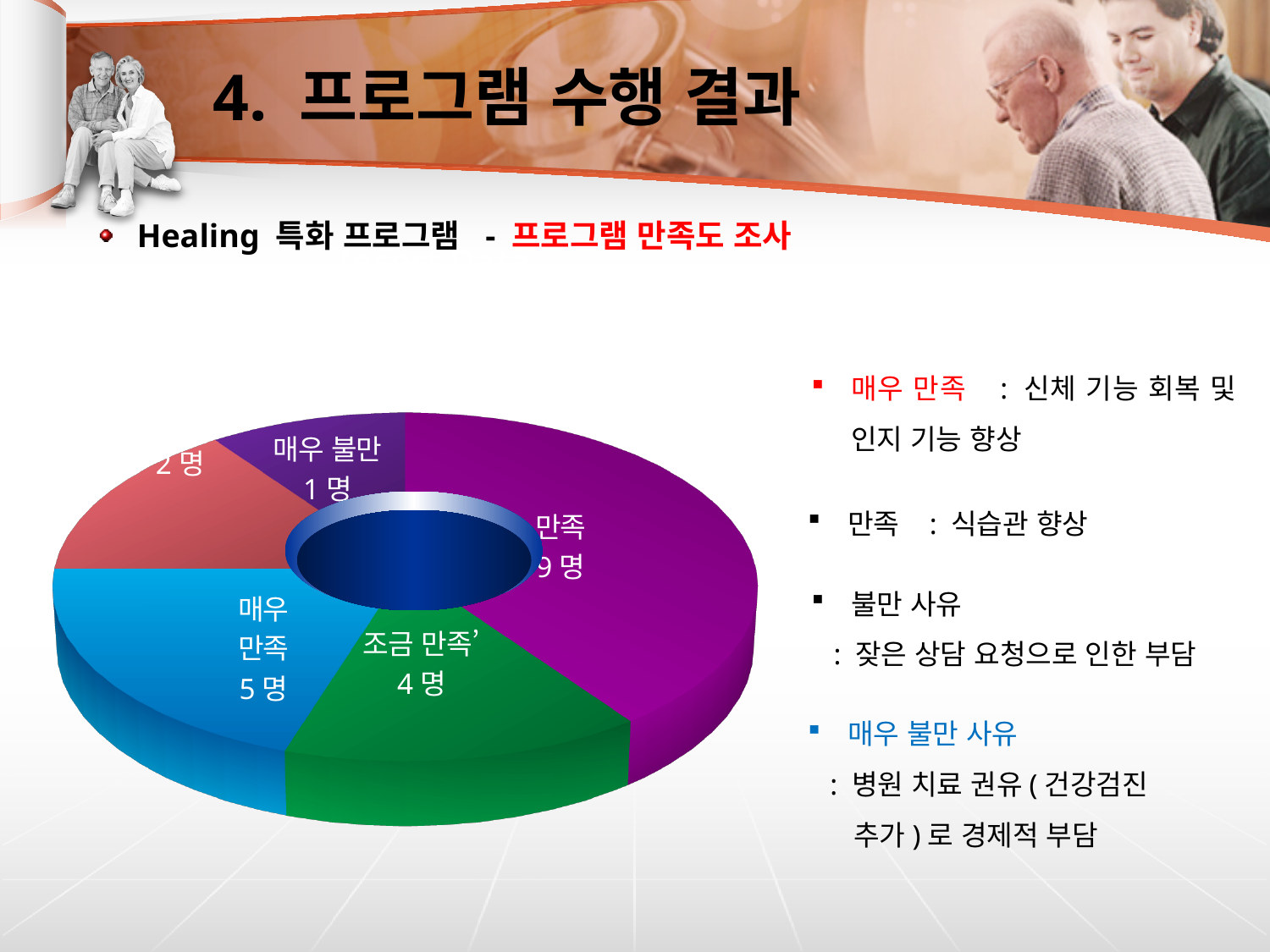
What is the total number of respondents across all segments of the chart? 21 명 How many people answered 매우 불만 in the chart? 1 명 Which category has the largest segment in the chart? 만족 Which has more responses, 매우 만족 or 조금 만족? 매우 만족 How many people answered 만족 in the satisfaction survey chart? 9 명 What is the value shown for 조금 만족 in the chart? 4 명 Which category has the smallest segment in the chart? 매우 불만 What is the difference between the number of 만족 responses and 매우 만족 responses? 4 명 How many segments does the doughnut chart have? 5 What colour is the 만족 segment in the chart? Purple What is the value shown for 매우 만족 in the chart? 5 명 What type of chart is shown on the slide? Doughnut chart